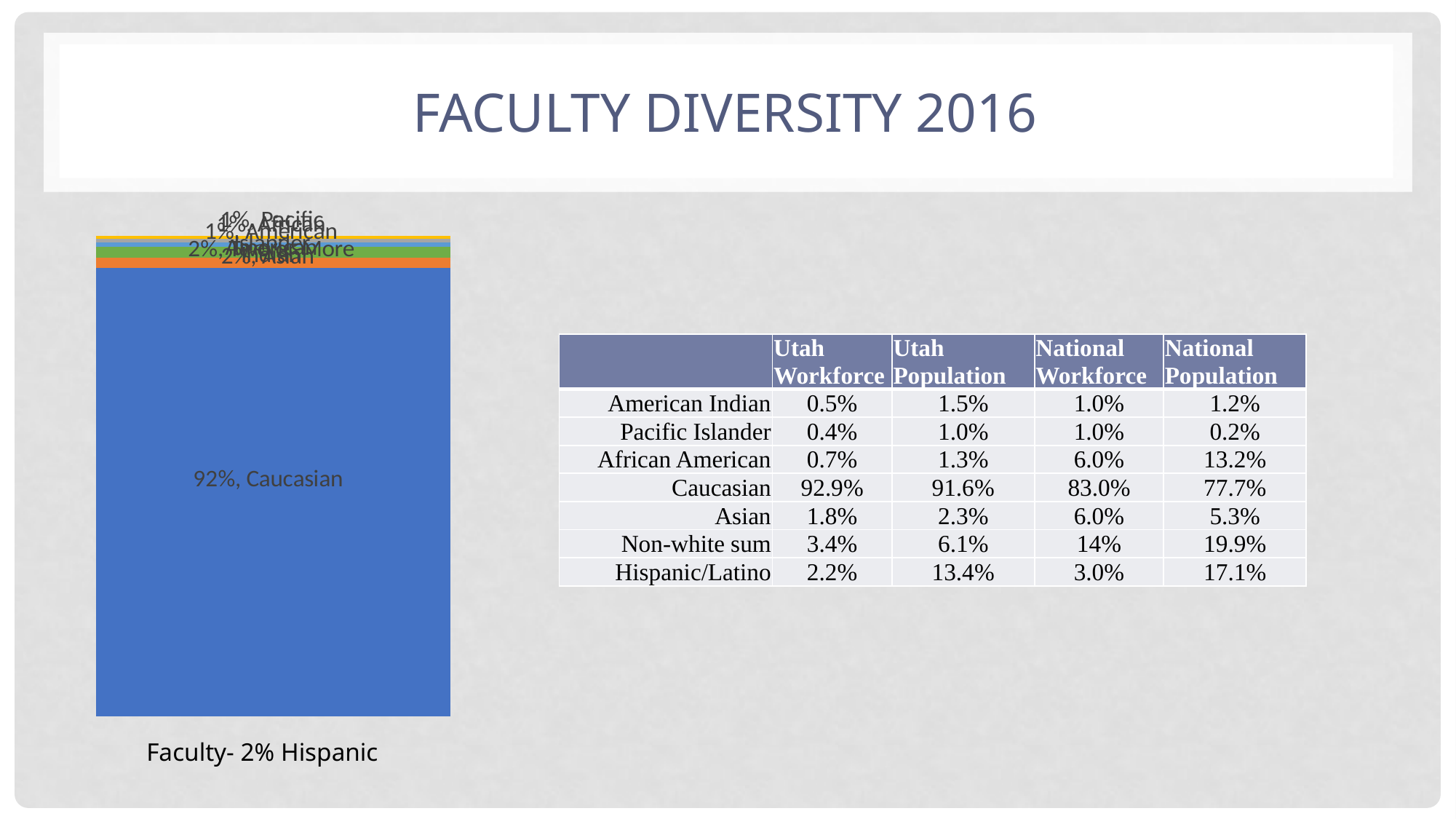
In the stacked bar chart, what is the difference between the Caucasian percentage and the Asian percentage? 90% In the stacked bar chart, what percentage is labelled for Asian? 2% In the stacked bar chart, what percentage is labelled for Caucasian? 92% What colour is the Caucasian segment in the stacked bar chart? blue In the stacked bar chart, which is larger, the Caucasian segment or the Asian segment? Caucasian In the stacked bar chart, which category has the largest segment? Caucasian What text appears directly below the stacked bar chart? Faculty- 2% Hispanic What kind of chart is shown on the left of the slide? bar chart